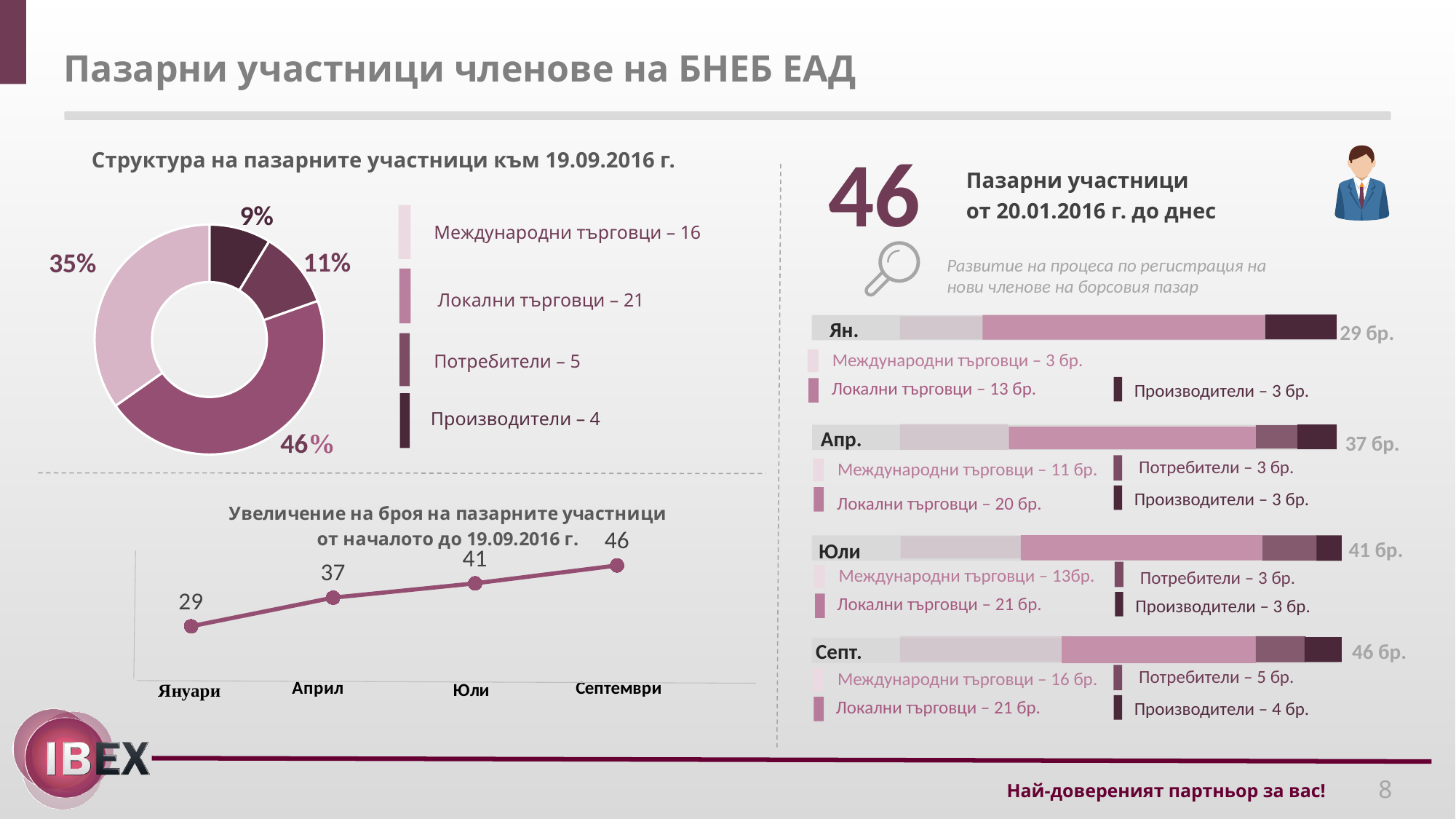
What type of chart is 'Увеличение на броя на пазарните участници от началото до 19.09.2016 г.'? line chart In the donut chart 'Структура на пазарните участници към 19.09.2016 г.', how many Международни търговци are listed in the legend? 16 In the stacked bars on the right side of the slide, what is the total for Апр.? 37 бр. In the line chart 'Увеличение на броя на пазарните участници от началото до 19.09.2016 г.', what is the difference between the Септември and Януари values? 17 In the donut chart 'Структура на пазарните участници към 19.09.2016 г.', how many categories does the legend list? 4 In the donut chart 'Структура на пазарните участници към 19.09.2016 г.', which category has the largest share? Локални търговци In the line chart 'Увеличение на броя на пазарните участници от началото до 19.09.2016 г.', what is the value for Април? 37 In the donut chart 'Структура на пазарните участници към 19.09.2016 г.', which category has the smallest share? Производители In the donut chart 'Структура на пазарните участници към 19.09.2016 г.', what is the difference in count between Локални търговци and Потребители? 16 In the stacked bars on the right side of the slide, how many Локални търговци are shown for Ян.? 13 бр. In the donut chart 'Структура на пазарните участници към 19.09.2016 г.', what share of the market participants are Локални търговци? 46% In the line chart 'Увеличение на броя на пазарните участници от началото до 19.09.2016 г.', do the values rise or fall from Януари to Септември? rise